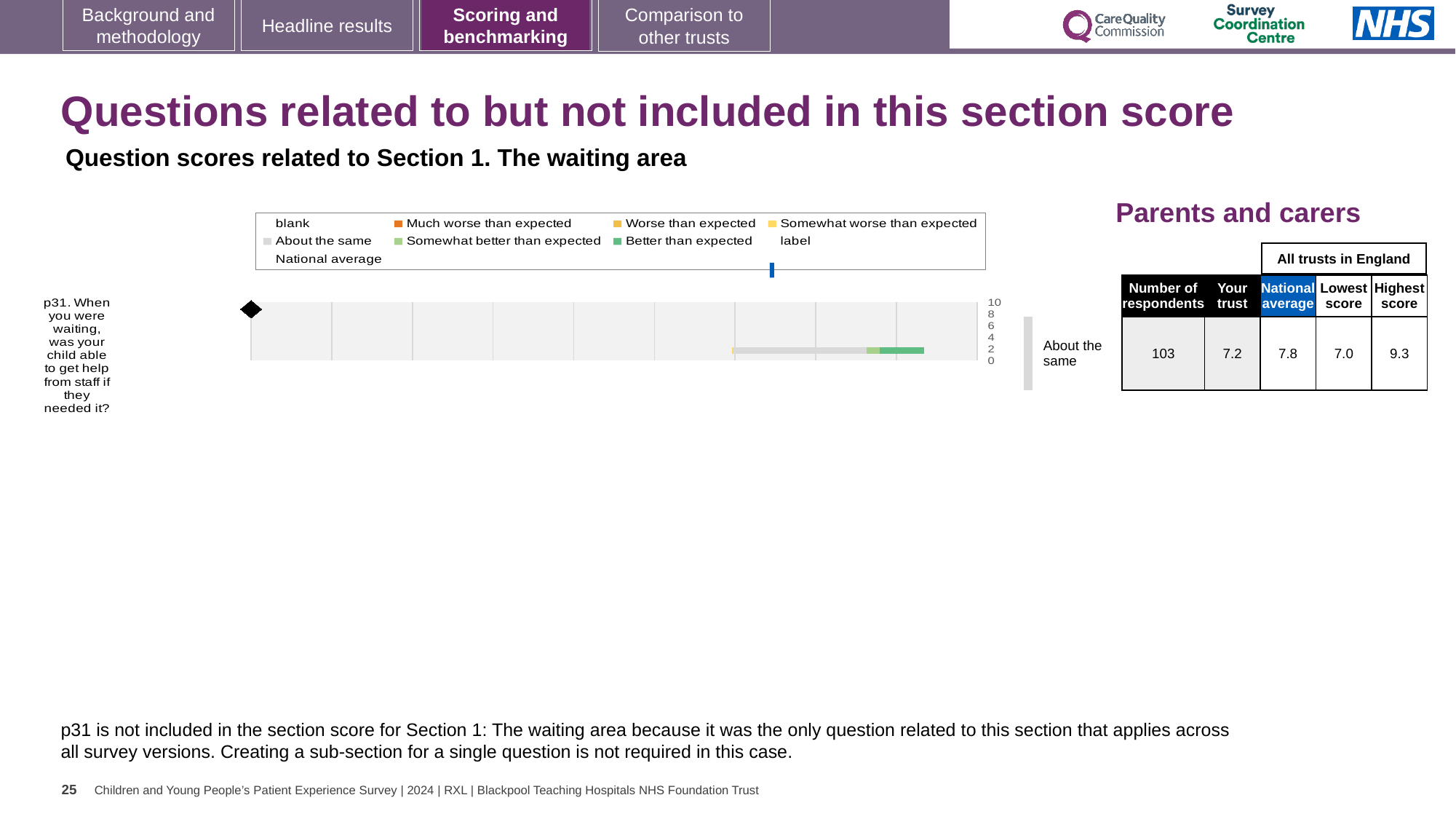
In the table, what is the number of respondents for p31? 103 How many entries does the chart legend list? 9 What benchmark label is shown to the right of the p31 bar? About the same In the table, what is the national average score for p31? 7.8 In the table, what is the 'Your trust' score for p31? 7.2 In the table, what is the lowest score among all trusts in England for p31? 7.0 How many questions (categories) are plotted in the chart? 1 What kind of chart is shown for question p31? bar chart In the table, what is the highest score among all trusts in England for p31? 9.3 What is the difference between the highest score and the lowest score for p31 in the table? 2.3 What is the highest value shown on the chart's axis? 10 Which is larger for p31, the 'Your trust' score or the national average? National average